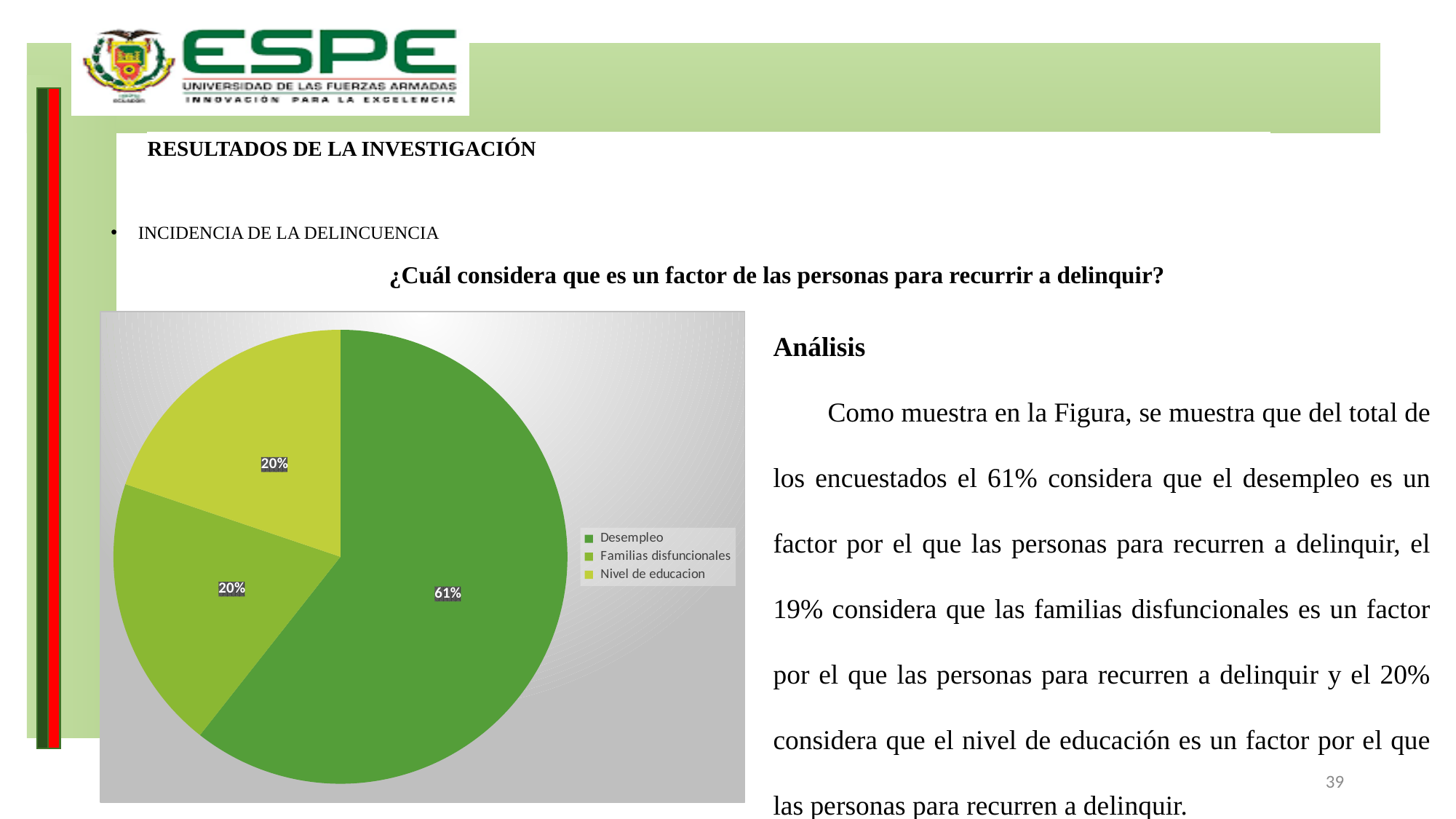
What percentage of the pie chart corresponds to Desempleo? 61% Which is larger in the pie chart, Desempleo or Nivel de educacion? Desempleo What type of chart is shown on the slide? Pie chart What question is the pie chart answering, according to the title above it? ¿Cuál considera que es un factor de las personas para recurrir a delinquir? What percentage of the pie chart corresponds to Familias disfuncionales? 20% Which category has the largest slice in the pie chart? Desempleo How many slices does the pie chart have? 3 How many entries does the legend of the pie chart list? 3 What is the difference in percentage points between the Desempleo slice and the Familias disfuncionales slice? 41 What share of the pie does the Desempleo slice represent? 61% What percentage of the pie chart corresponds to Nivel de educacion? 20% What are the three legend entries of the pie chart? Desempleo, Familias disfuncionales, Nivel de educacion